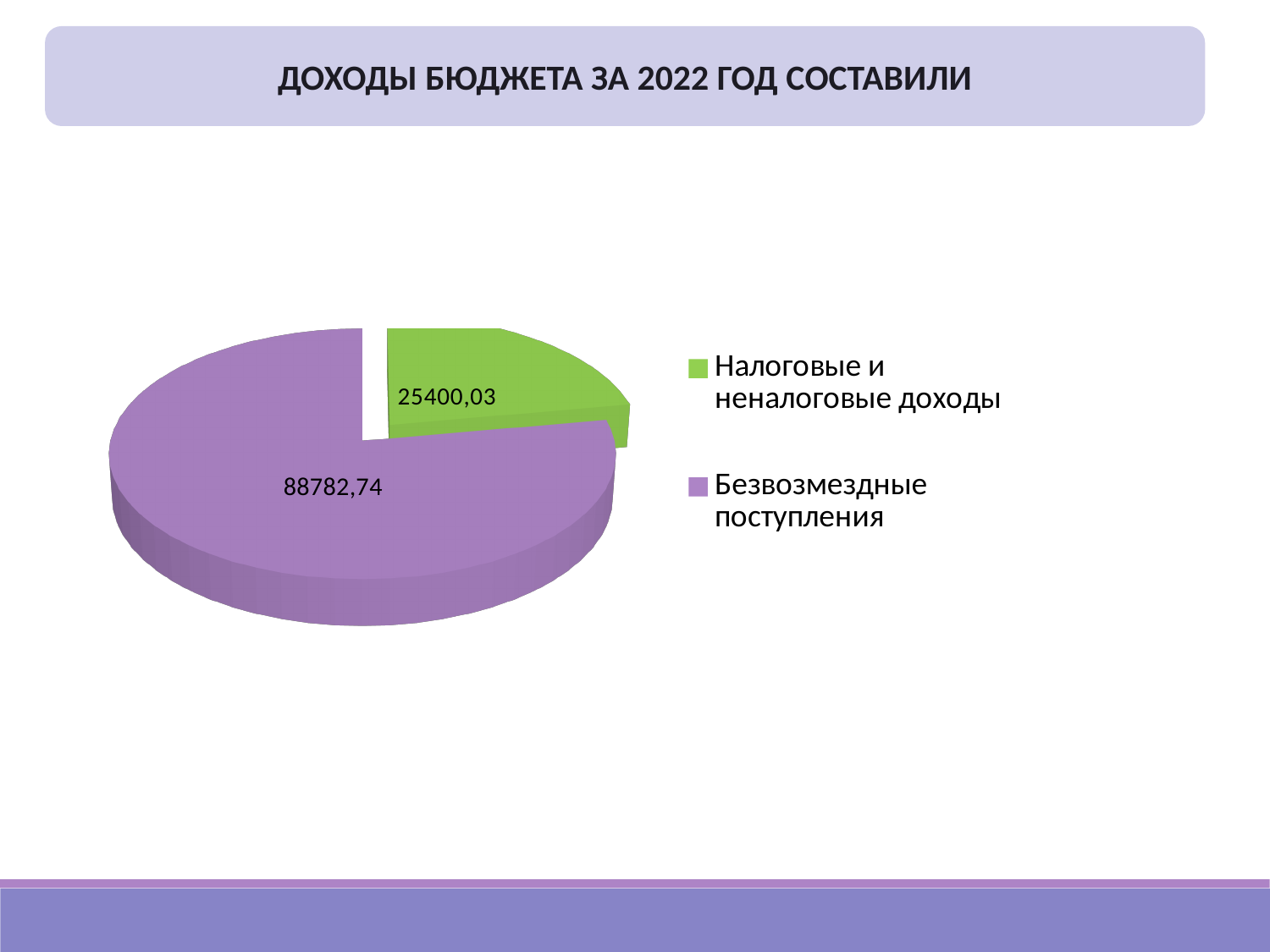
What is the total of the two slices in the pie chart? 114182,77 Which category has the smallest slice of the pie? Налоговые и неналоговые доходы How many slices does the pie chart have? 2 What is the value for Безвозмездные поступления? 88782,74 How many entries does the legend list? 2 What is the difference between Безвозмездные поступления and Налоговые и неналоговые доходы? 63382,71 What colour is the slice for Налоговые и неналоговые доходы? Green What is the value for Налоговые и неналоговые доходы? 25400,03 What type of chart is shown on the slide? Pie chart Which is larger: Налоговые и неналоговые доходы or Безвозмездные поступления? Безвозмездные поступления Which category has the largest slice of the pie? Безвозмездные поступления What is the title of the slide containing the chart? ДОХОДЫ БЮДЖЕТА ЗА 2022 ГОД СОСТАВИЛИ